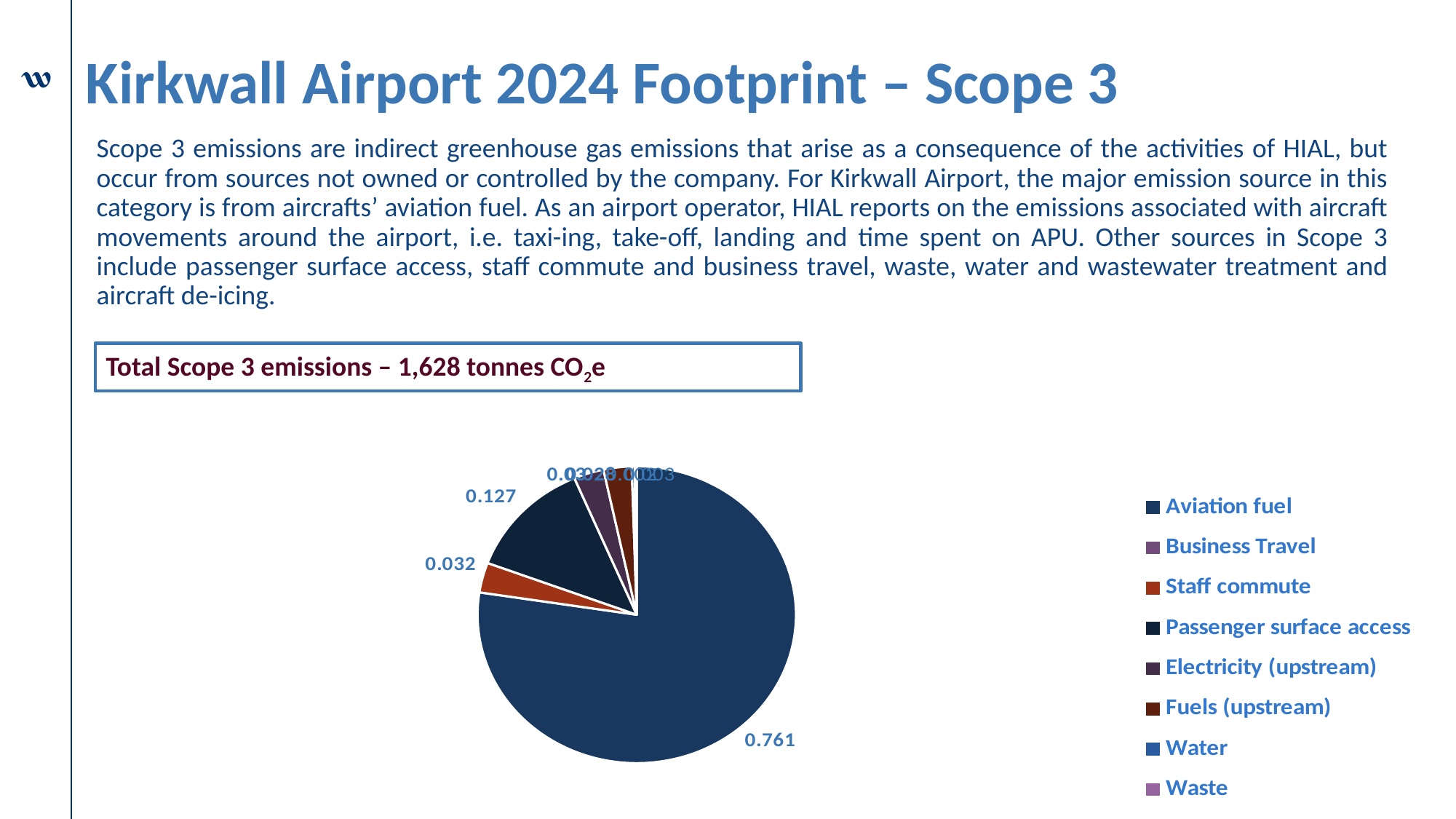
What kind of chart is shown on the slide? pie chart Which category has the largest slice of the pie chart? Aviation fuel What share of the pie chart does Aviation fuel account for? 0.761 Which legend category of the pie chart is shown in red-orange? Staff commute What value is labelled on the Staff commute slice of the pie chart? 0.032 What is the difference between the Passenger surface access value and the Staff commute value in the pie chart? 0.095 According to the boxed text above the pie chart, what are the total Scope 3 emissions? 1,628 tonnes CO2e How many categories does the legend of the pie chart list? 8 What value is labelled on the Passenger surface access slice of the pie chart? 0.127 What value is labelled on the Aviation fuel slice of the pie chart? 0.761 Which is larger in the pie chart, Passenger surface access or Staff commute? Passenger surface access What is the difference between the Aviation fuel value and the Passenger surface access value in the pie chart? 0.634